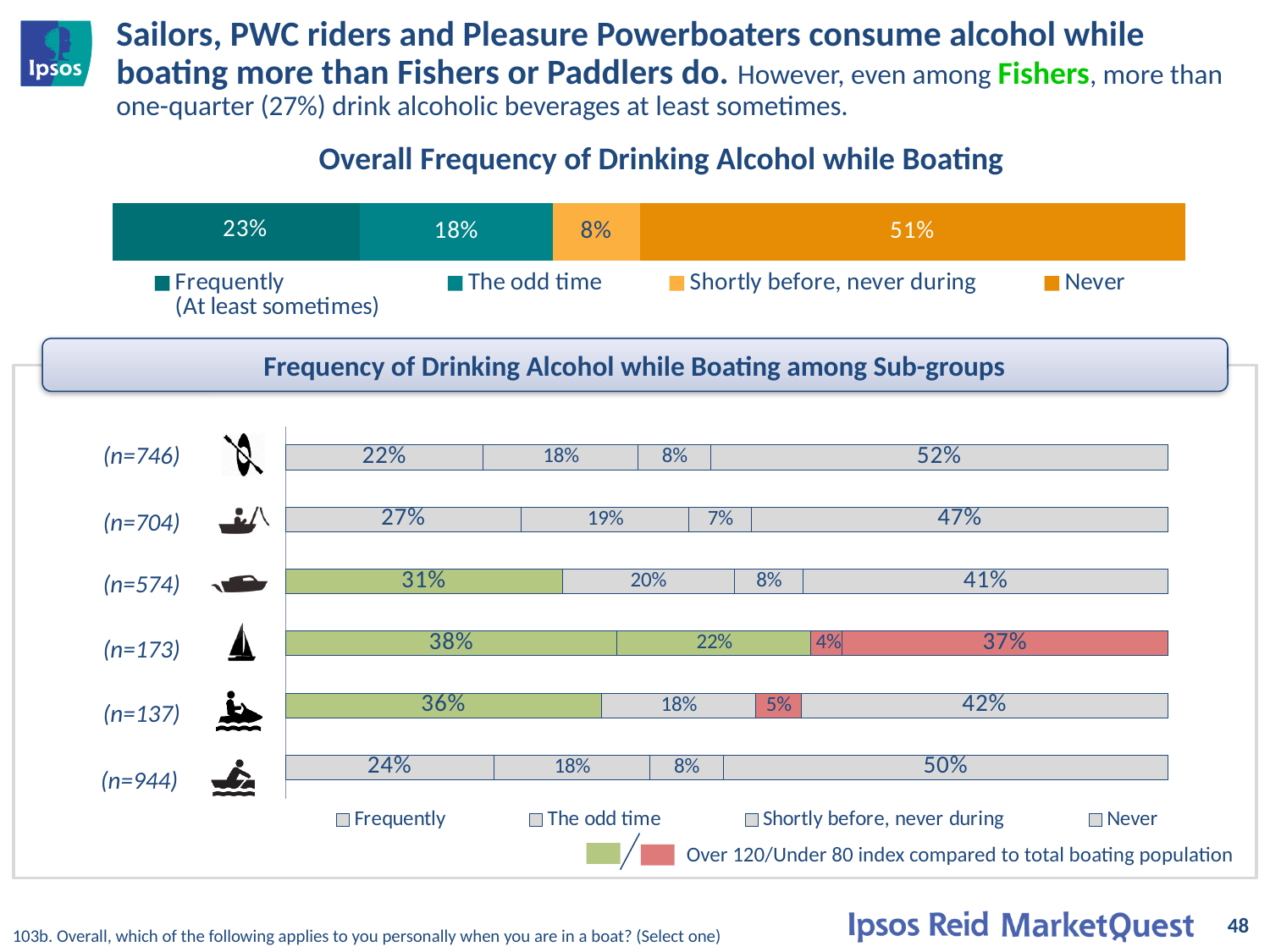
What kind of chart is the 'Frequency of Drinking Alcohol while Boating among Sub-groups' chart? Stacked bar chart In the 'Frequency of Drinking Alcohol while Boating among Sub-groups' chart, what is the 'Never' value for the (n=574) row? 41% In the 'Frequency of Drinking Alcohol while Boating among Sub-groups' chart, which row has the larger 'Frequently' value, (n=137) or (n=704)? (n=137) In the 'Overall Frequency of Drinking Alcohol while Boating' chart, what percentage is shown for 'Never'? 51% In the 'Overall Frequency of Drinking Alcohol while Boating' chart, how many percentage points higher is 'Frequently (At least sometimes)' than 'The odd time'? 5 percentage points In the 'Overall Frequency of Drinking Alcohol while Boating' chart, which category has the smallest share? Shortly before, never during In the 'Frequency of Drinking Alcohol while Boating among Sub-groups' chart, which row has the lowest 'Never' value? (n=173) In the 'Overall Frequency of Drinking Alcohol while Boating' chart, which category has the largest share? Never In the 'Frequency of Drinking Alcohol while Boating among Sub-groups' chart, what is the 'Frequently' value for the (n=173) row? 38% In the 'Frequency of Drinking Alcohol while Boating among Sub-groups' chart, which row has the highest 'Frequently' value? (n=173) How many categories does the legend of the 'Overall Frequency of Drinking Alcohol while Boating' chart list? 4 How many sub-group rows are plotted in the 'Frequency of Drinking Alcohol while Boating among Sub-groups' chart? 6